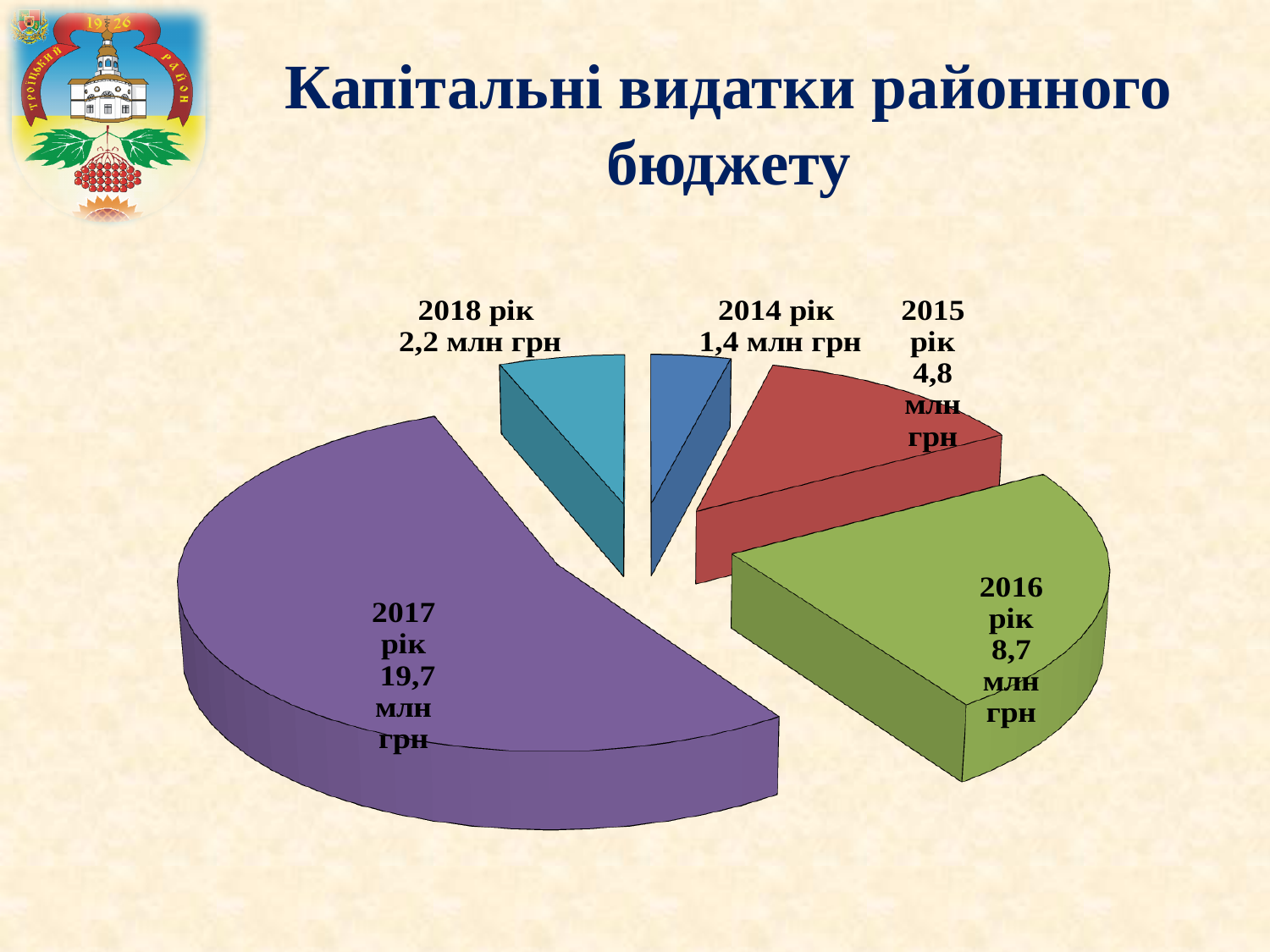
What is the value for 2014 рік? 1,4 млн грн What type of chart is shown on the slide? Pie chart What is the value for 2018 рік? 2,2 млн грн Which year has the largest slice of the pie? 2017 рік What is the difference between the values for 2017 рік and 2016 рік? 11 млн грн Which year has the smallest slice of the pie? 2014 рік What is the title of the chart on the slide? Капітальні видатки районного бюджету What is the value for 2016 рік? 8,7 млн грн How many slices does the pie chart have? 5 Which is larger, the value for 2018 рік or the value for 2015 рік? 2015 рік What is the value for 2017 рік? 19,7 млн грн What is the difference between the values for 2016 рік and 2015 рік? 3,9 млн грн